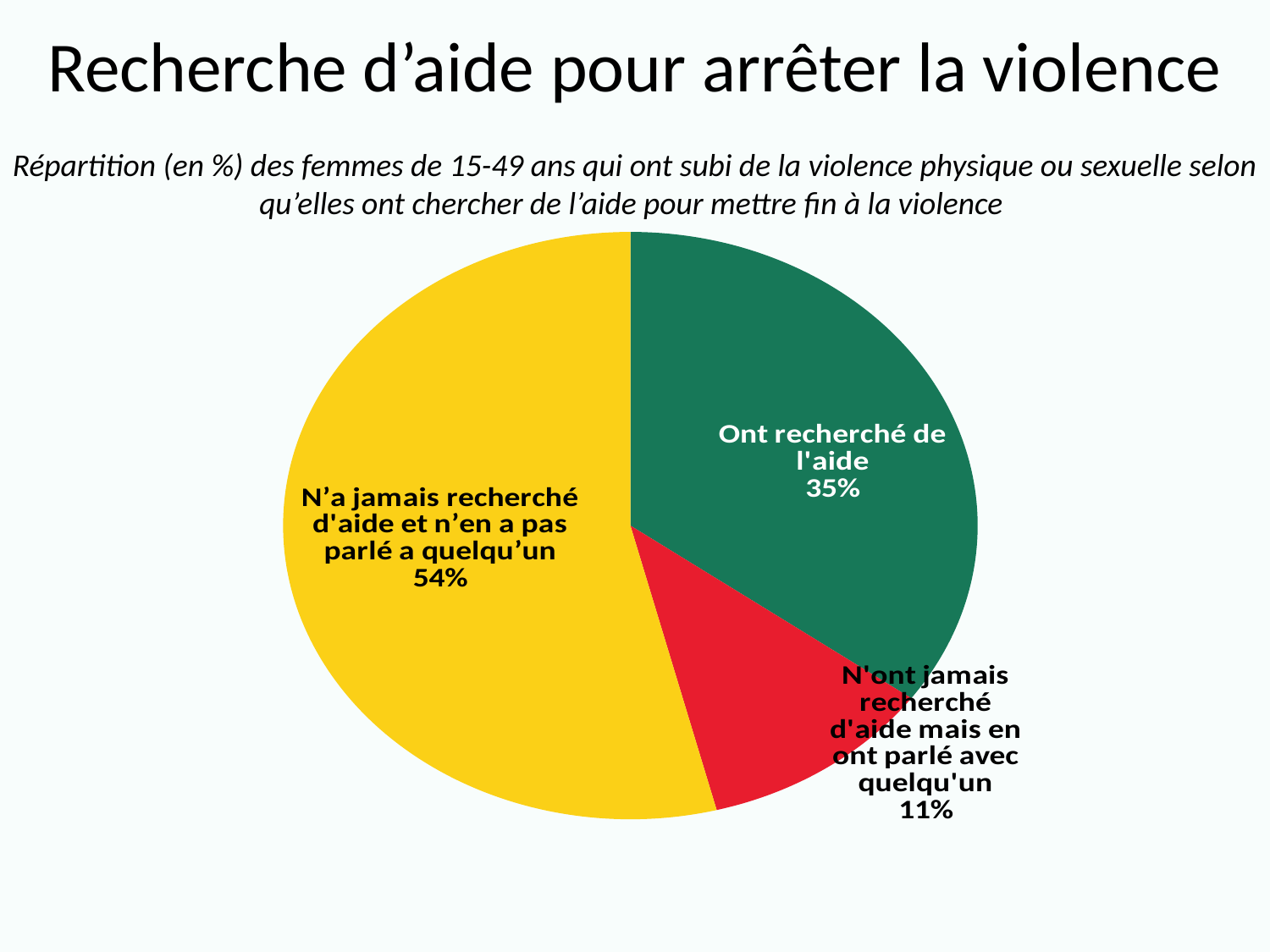
What is the title of the slide? Recherche d'aide pour arrêter la violence What colour is the slice for women who sought help ("Ont recherché de l'aide")? Green What percentage of women sought help ("Ont recherché de l'aide")? 35% What type of chart is shown on the slide? Pie chart How many categories are shown in the pie chart? 3 What is the combined share of the two categories of women who never sought help? 65% What percentage of women never sought help but talked to someone about it ("N'ont jamais recherché d'aide mais en ont parlé avec quelqu'un")? 11% What is the difference in percentage points between the share that never sought help and did not talk to anyone and the share that sought help? 19 Which category has the largest share of the pie? N'a jamais recherché d'aide et n'en a pas parlé a quelqu'un Which is larger: the share that sought help or the share that never sought help but talked to someone? Ont recherché de l'aide What percentage of women never sought help and did not talk to anyone ("N'a jamais recherché d'aide et n'en a pas parlé a quelqu'un")? 54% Which category has the smallest share of the pie? N'ont jamais recherché d'aide mais en ont parlé avec quelqu'un